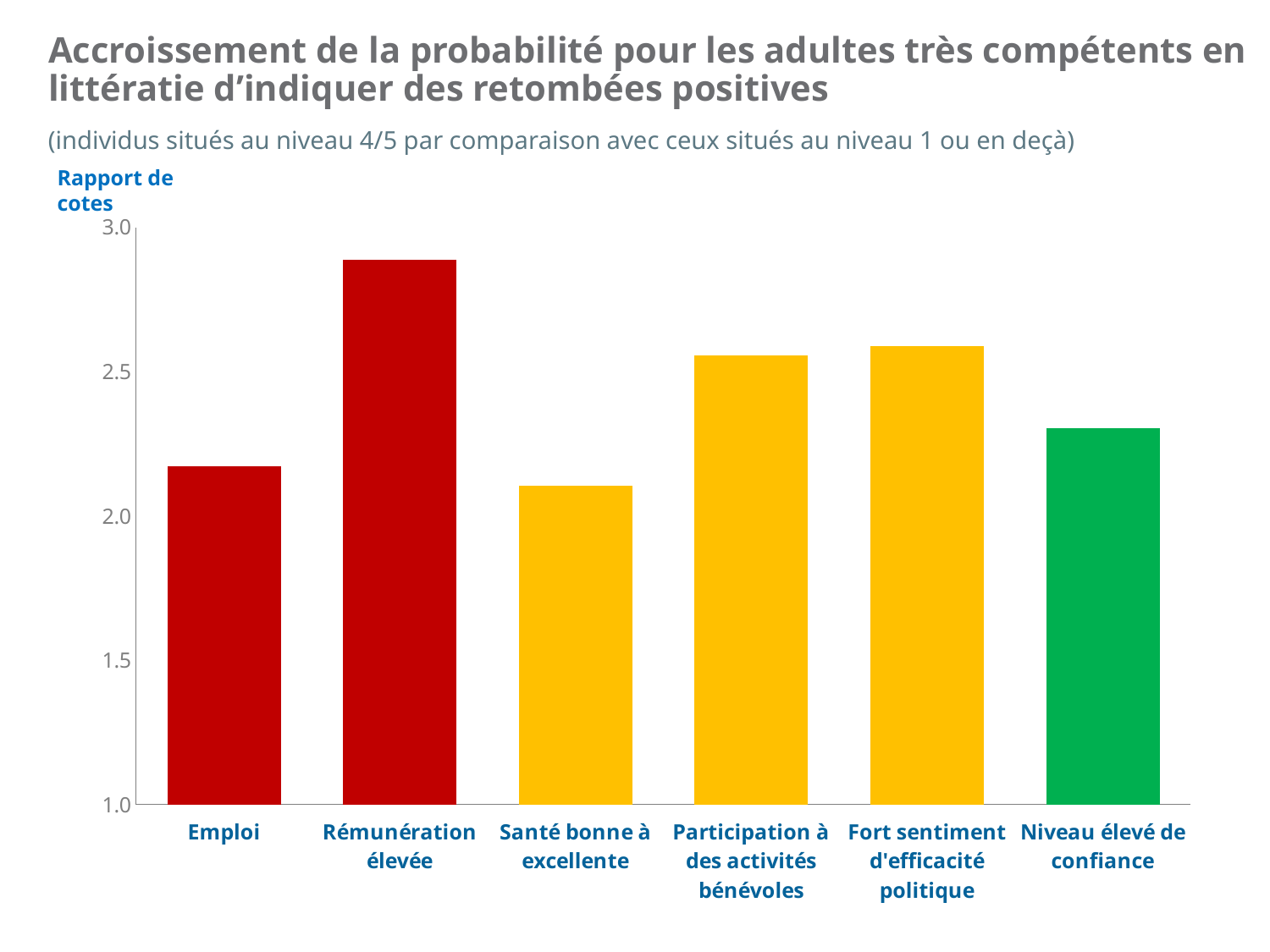
Which category has the highest value? Rémunération élevée Is the value for Rémunération élevée greater or less than 2.5? greater What kind of chart is shown on the slide? bar chart How many categories are plotted on the chart? 6 What colour is the bar for Niveau élevé de confiance? green Which is larger, the value for Emploi or the value for Niveau élevé de confiance? Niveau élevé de confiance Which is larger, the value for Santé bonne à excellente or the value for Participation à des activités bénévoles? Participation à des activités bénévoles Is the value for Emploi greater or less than 2.5? less What is the label on the vertical axis of the chart? Rapport de cotes Is the value for Niveau élevé de confiance greater or less than 2.5? less